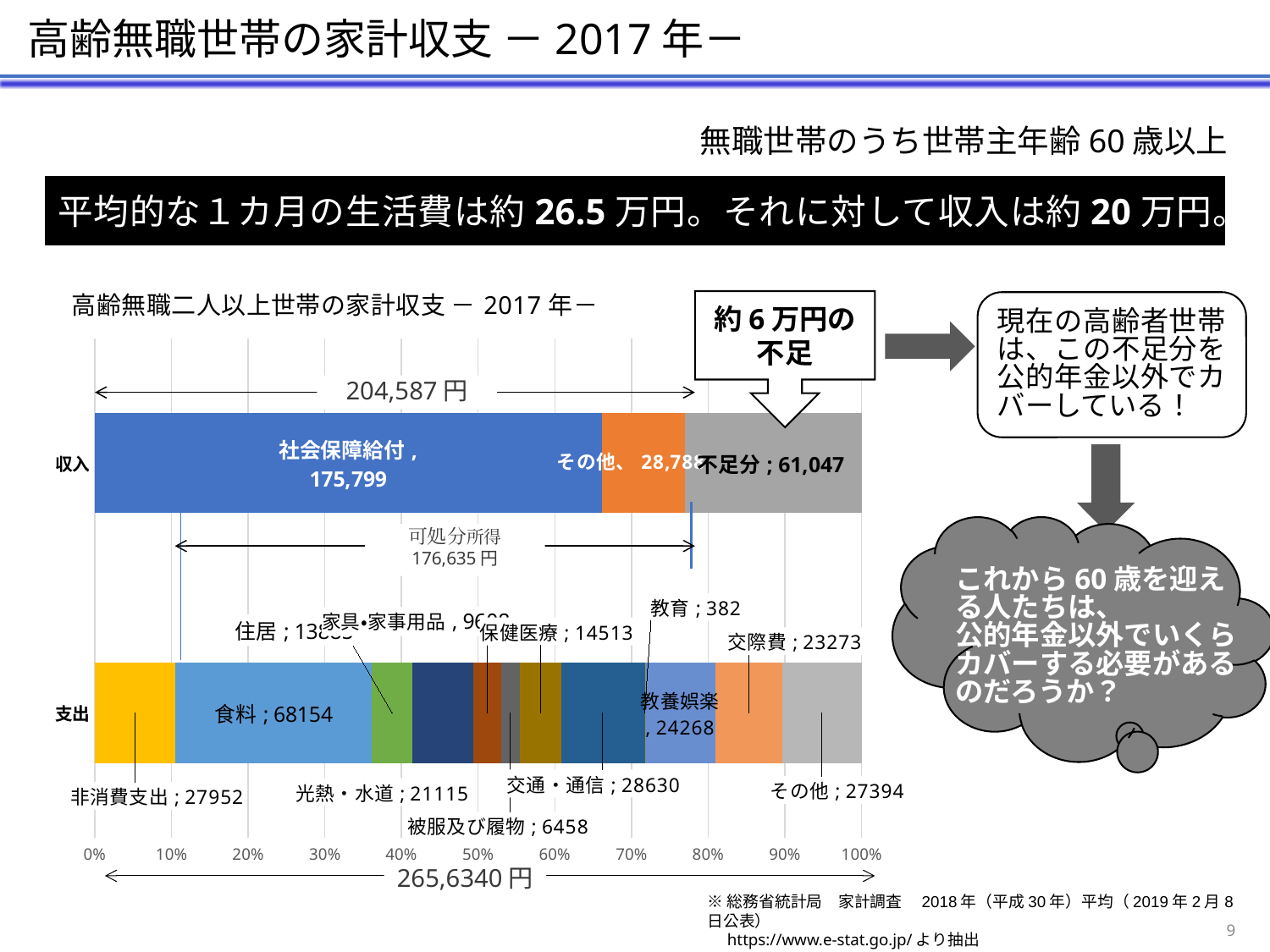
What is the value of 不足分 in the 収入 bar? 61,047 Which segment of the 支出 bar has the smallest value? 教育 What is the value of 被服及び履物 in the 支出 bar? 6458 What is the title of the chart? 高齢無職二人以上世帯の家計収支 － 2017 年－ What is the value of 教育 in the 支出 bar? 382 What total amount is shown by the arrow above the 収入 bar? 204,587 円 Which segment of the 支出 bar has the largest value? 食料 What is the value of 食料 in the 支出 bar? 68154 What kind of chart is shown on the slide? Stacked bar chart What is the difference between 交通・通信 and 交際費 in the 支出 bar? 5357 What is the value of 社会保障給付 in the 収入 bar? 175,799 Which is larger in the 支出 bar, 教養娯楽 or 交際費? 教養娯楽